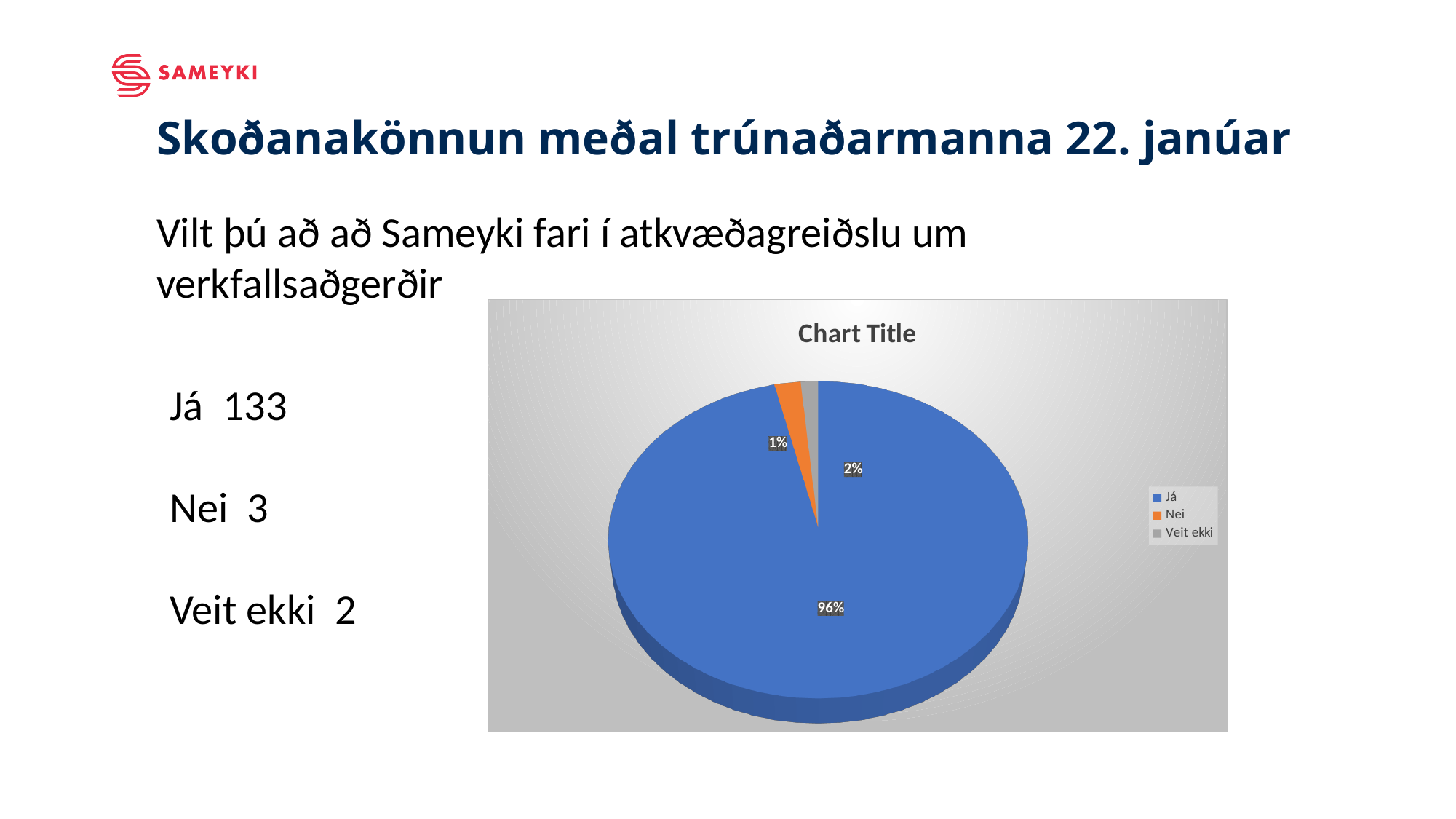
How many slices does the pie chart have? 3 Which is larger in the pie chart, the Já slice or the Nei slice? Já Is the share of the Já slice greater or less than 50%? greater Which category has the largest slice in the pie chart? Já What is the title shown above the pie chart? Chart Title What percentage share does the Já slice have in the pie chart? 96% Which category has the smallest slice in the pie chart? Veit ekki Which colour represents Nei in the pie chart? orange What kind of chart is shown on the slide? pie chart How many entries does the legend of the pie chart list? 3